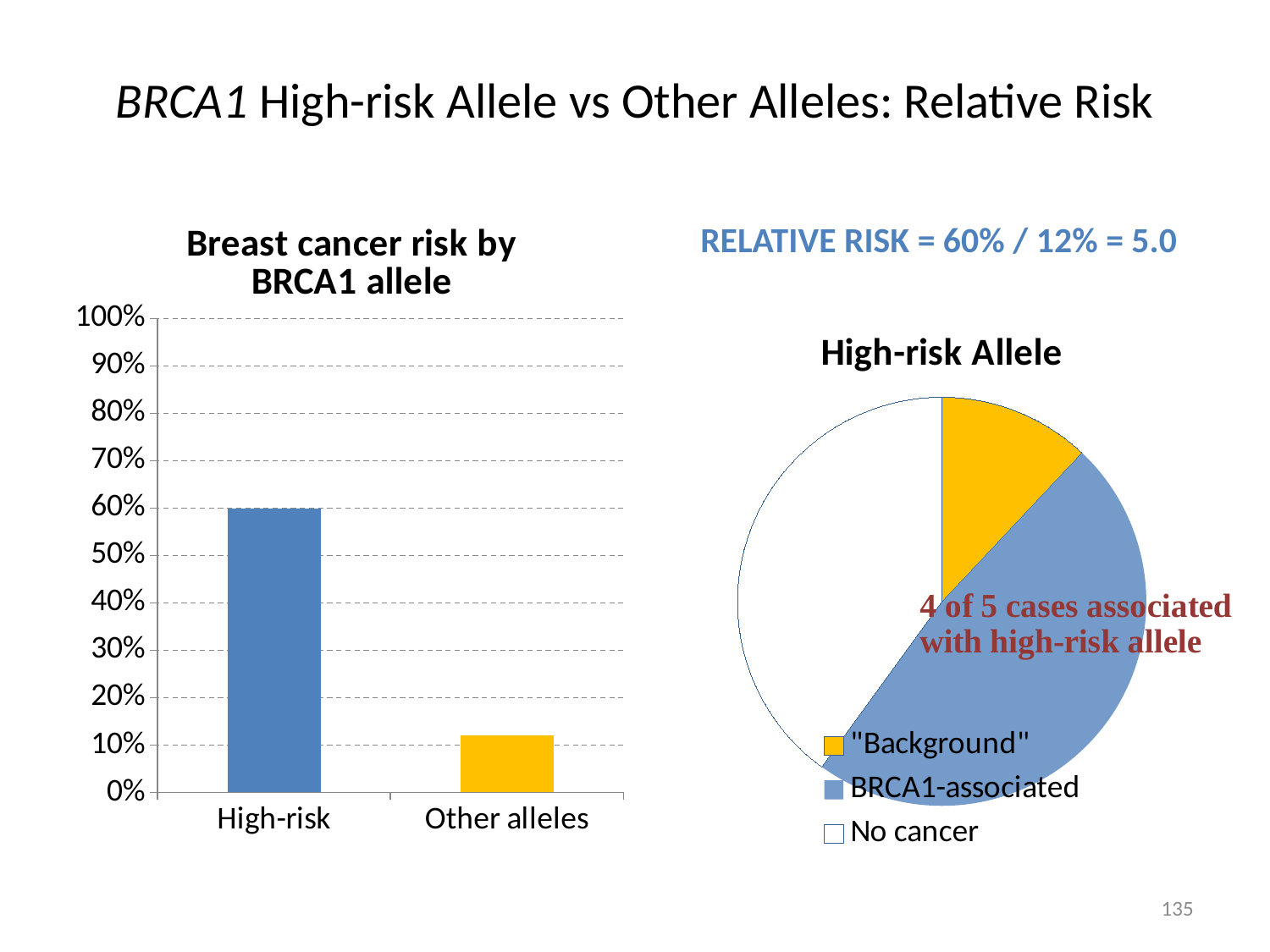
In the bar chart titled "Breast cancer risk by BRCA1 allele", which category has the lowest value? Other alleles What kind of chart is the chart titled "Breast cancer risk by BRCA1 allele"? bar chart In the bar chart titled "Breast cancer risk by BRCA1 allele", which category has the highest value? High-risk In the bar chart titled "Breast cancer risk by BRCA1 allele", is the value for Other alleles greater or less than 10%? greater In the bar chart titled "Breast cancer risk by BRCA1 allele", is the value for Other alleles greater or less than 20%? less In the pie chart titled "High-risk Allele", which slice is the smallest? "Background" How many categories are shown in the bar chart titled "Breast cancer risk by BRCA1 allele"? 2 How many entries does the legend of the pie chart titled "High-risk Allele" list? 3 In the bar chart titled "Breast cancer risk by BRCA1 allele", which is larger, High-risk or Other alleles? High-risk What kind of chart is the chart titled "High-risk Allele"? pie chart In the pie chart titled "High-risk Allele", what colour is the BRCA1-associated slice? blue In the bar chart titled "Breast cancer risk by BRCA1 allele", what is the value for High-risk? 60%